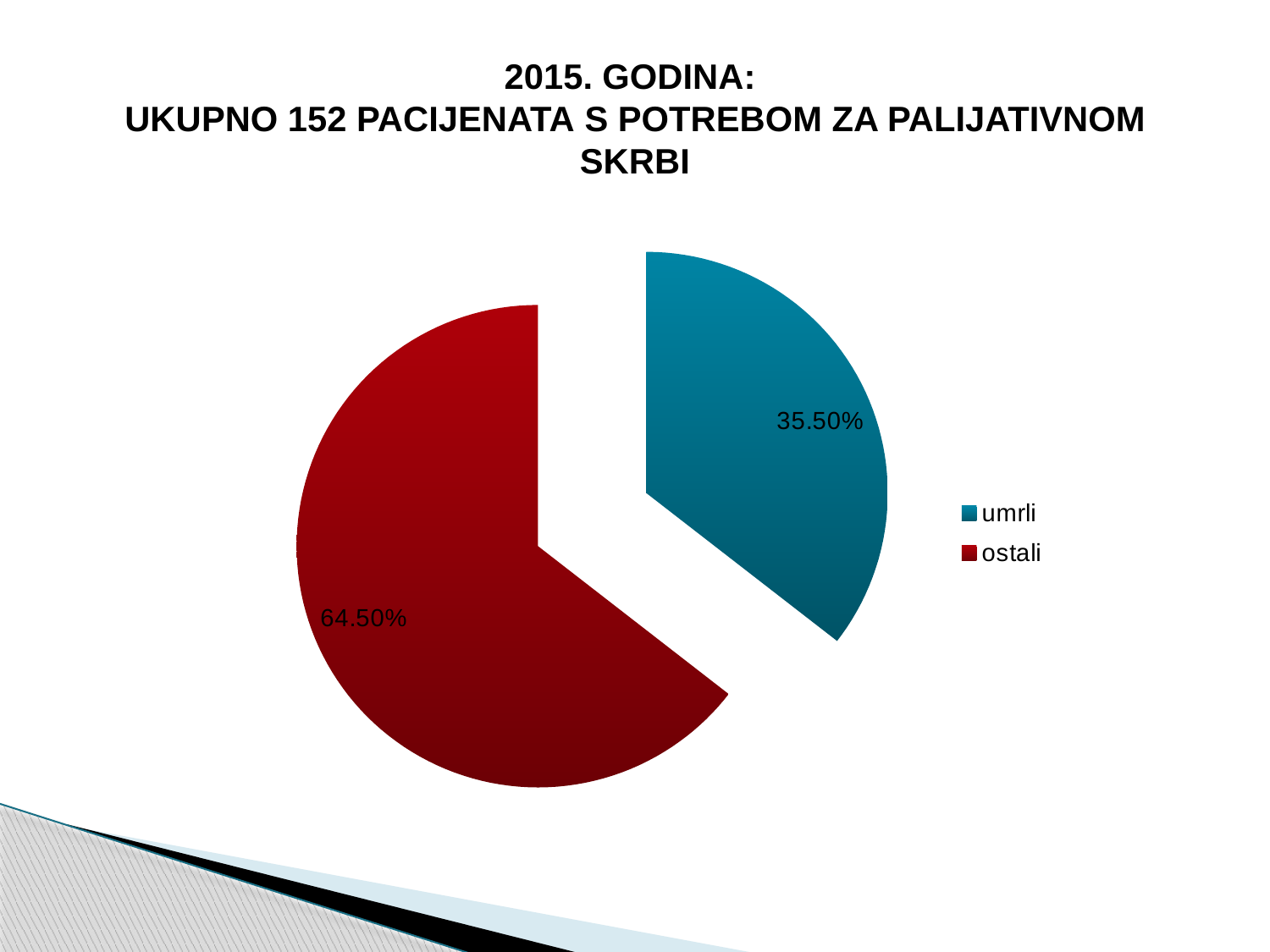
What colour is the "ostali" slice? red How many slices does the pie chart have? 2 What colour is the "umrli" slice? blue What share of the pie does the "umrli" slice represent? 35.50% Which slice is the smallest? umrli Which slice is the largest? ostali What share of the pie does the "ostali" slice represent? 64.50% How many entries does the legend list? 2 What is the total number of patients stated in the slide title? 152 Which is larger, the "umrli" slice or the "ostali" slice? ostali What kind of chart is shown on the slide? pie chart What is the difference in percentage points between the "ostali" and "umrli" slices? 29 percentage points